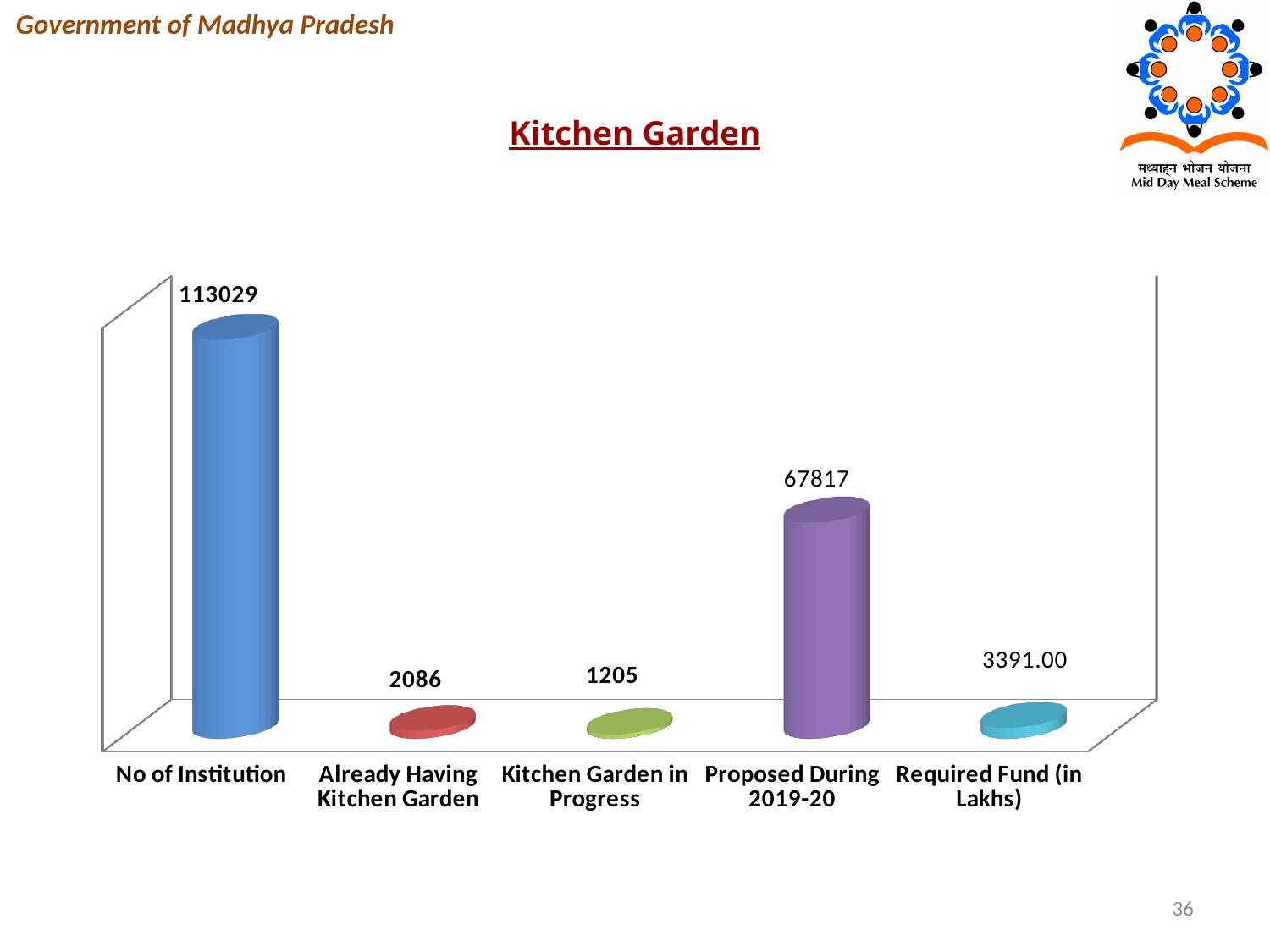
What is the value for Required Fund (in Lakhs)? 3391.00 Which is larger, Already Having Kitchen Garden or Kitchen Garden in Progress? Already Having Kitchen Garden What is the difference between Already Having Kitchen Garden and Kitchen Garden in Progress? 881 Which category has the highest value? No of Institution What is the value for Kitchen Garden in Progress? 1205 What is the value for No of Institution? 113029 Which category has the lowest value? Kitchen Garden in Progress What is the value for Already Having Kitchen Garden? 2086 What is the value for Proposed During 2019-20? 67817 What type of chart is shown on the slide? Bar chart How many categories are shown in the chart? 5 What is the difference between No of Institution and Proposed During 2019-20? 45212